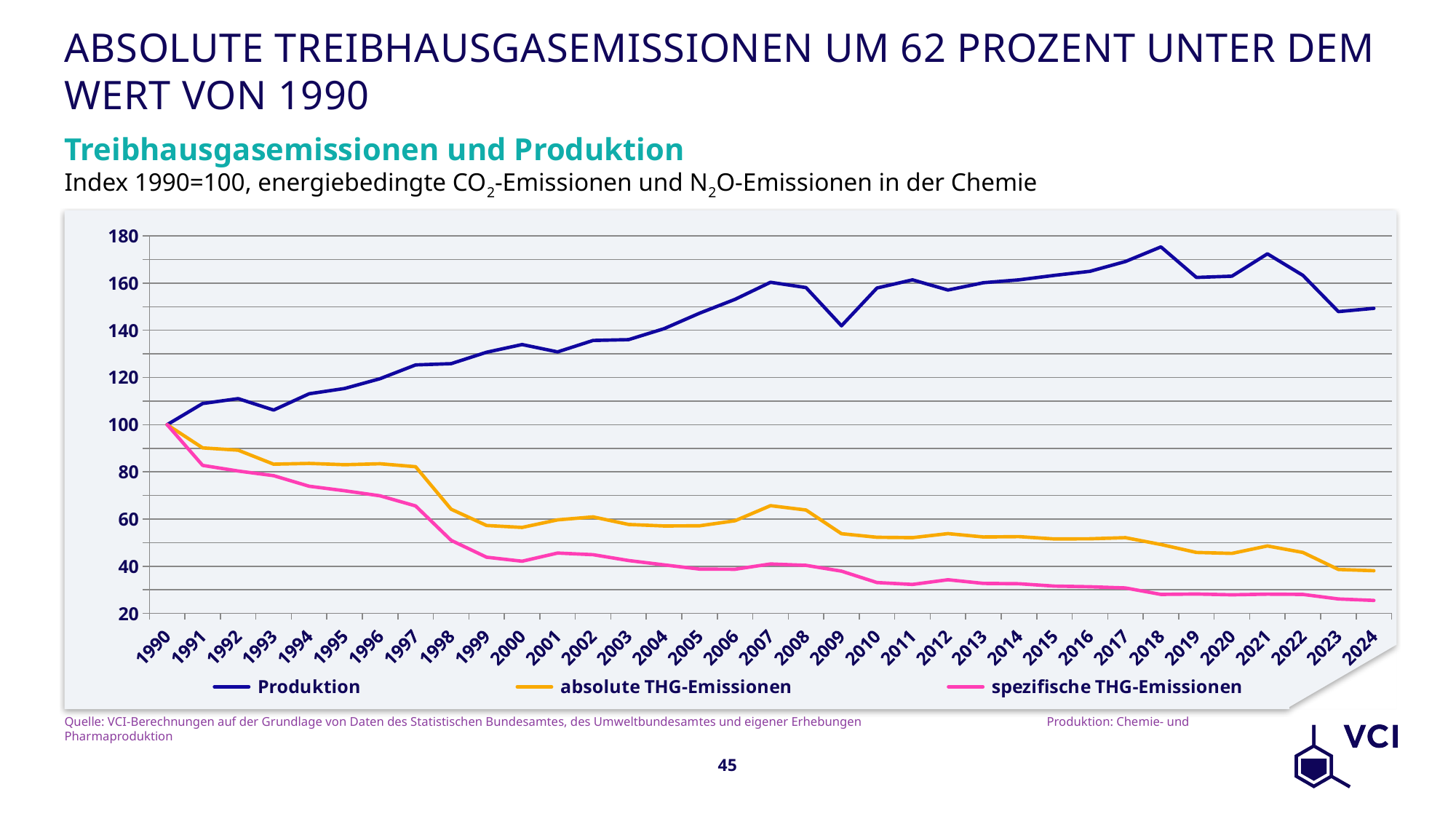
What is the index value of Produktion in 1990? 100 Is the value for absolute THG-Emissionen in 2024 greater or less than 60? less Does the spezifische THG-Emissionen line rise or fall overall from 1990 to 2024? fall What kind of chart is shown on the slide? line chart How many years are plotted along the x axis? 35 Is the value for Produktion in 2018 greater or less than 160? greater Which is larger: the Produktion value in 2008 or in 2009? 2008 Is the value for spezifische THG-Emissionen in 2024 greater or less than 40? less Which series has the lowest value in 2024? spezifische THG-Emissionen How many series does the legend list? 3 Does the Produktion line rise or fall overall from 1990 to 2024? rise What is the title of the chart? Treibhausgasemissionen und Produktion